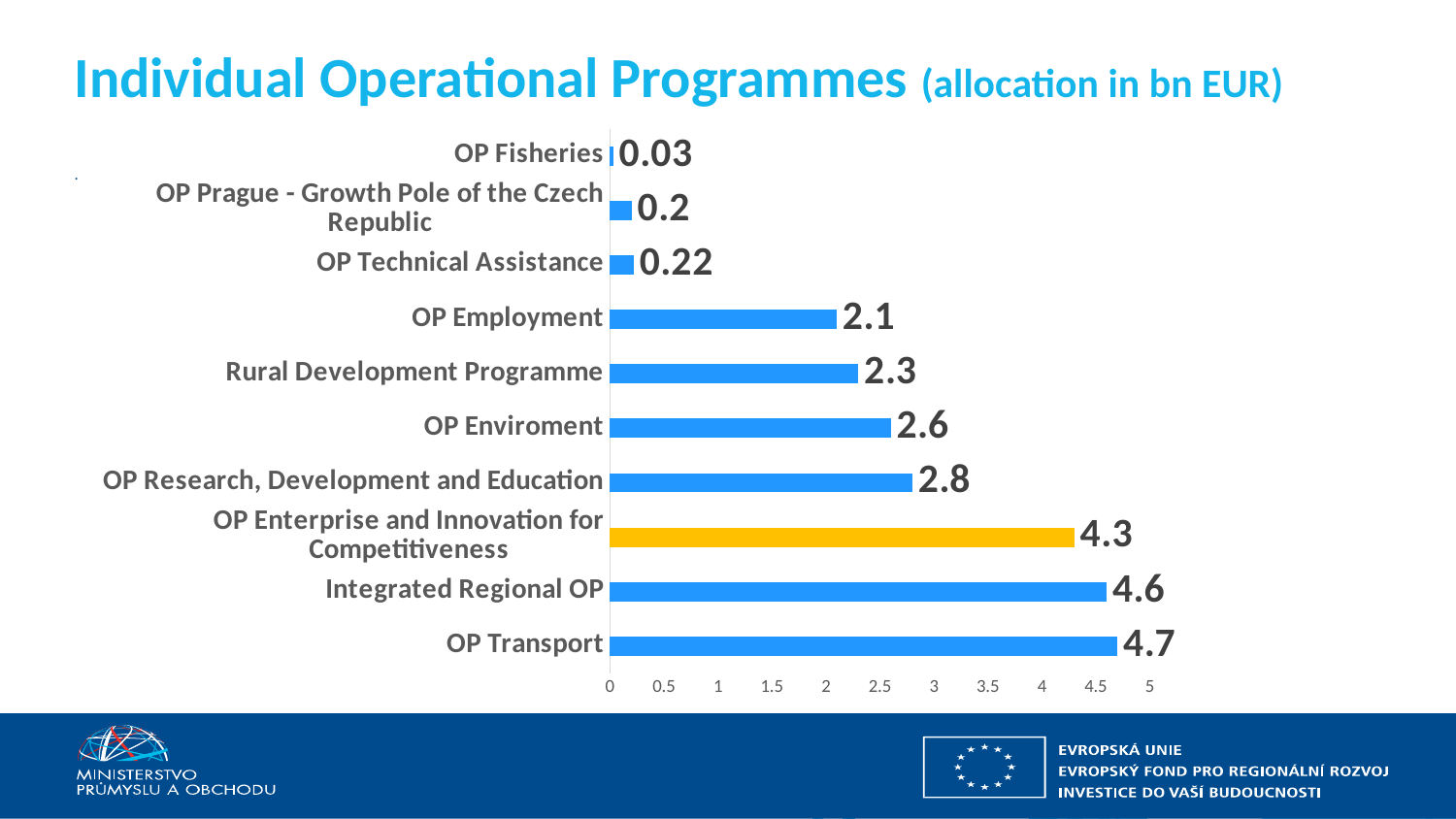
What is the allocation for OP Fisheries? 0.03 What kind of chart is shown on the slide? Bar chart What is the difference between the allocations for Integrated Regional OP and OP Employment? 2.5 What is the allocation for the Rural Development Programme? 2.3 In what unit are the allocations given, according to the title? bn EUR Which operational programme has the highest allocation? OP Transport Which operational programme has the lowest allocation? OP Fisheries What is the allocation for OP Transport? 4.7 Which bar is coloured differently (yellow) from the others? OP Enterprise and Innovation for Competitiveness What is the allocation for OP Enterprise and Innovation for Competitiveness? 4.3 How many operational programmes are shown in the chart? 10 Which has a larger allocation, OP Enviroment or OP Research, Development and Education? OP Research, Development and Education